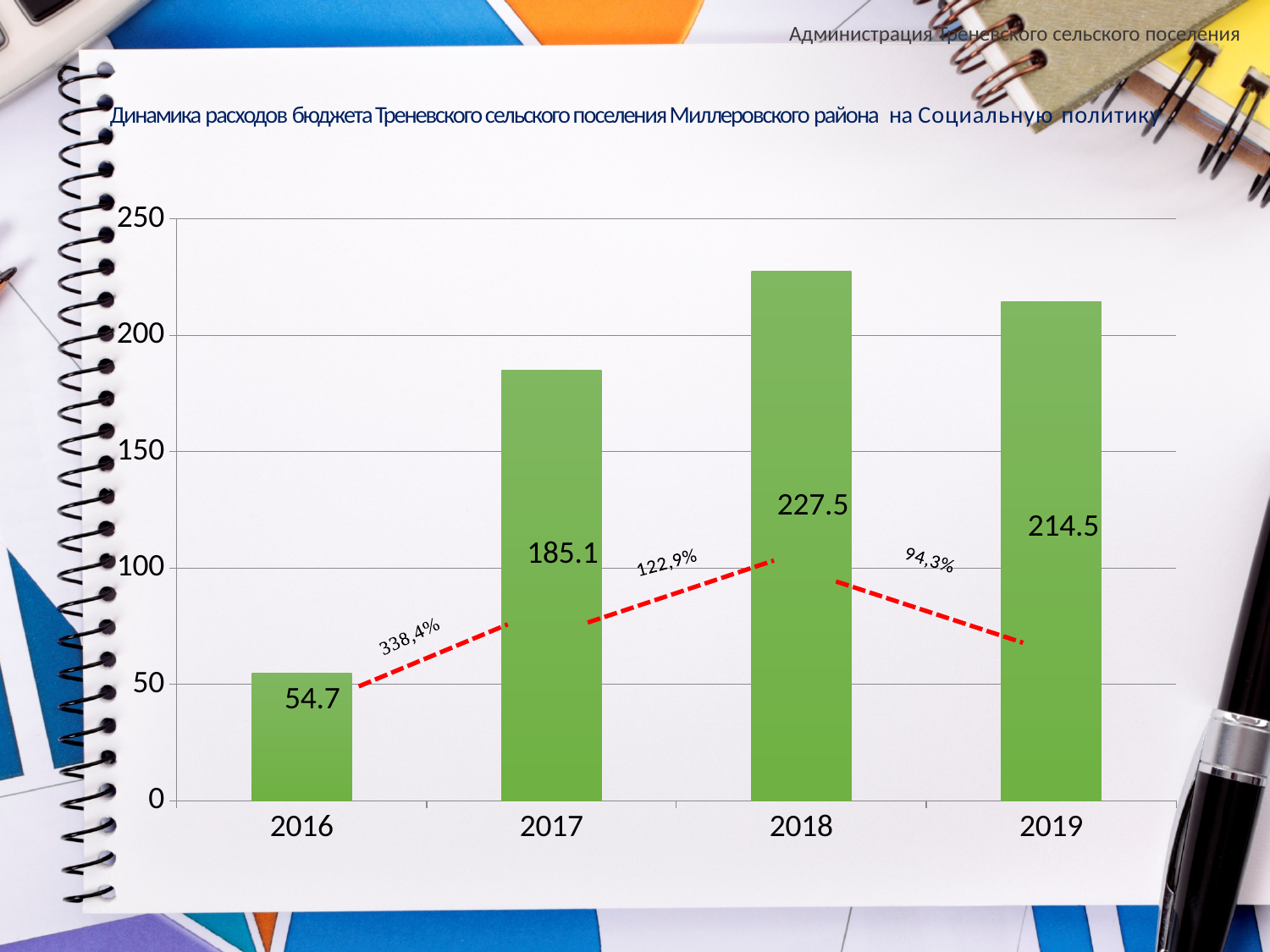
What kind of chart is this? bar chart How many years are shown on the x axis? 4 What is the value for 2019? 214.5 What percentage change is labelled on the dashed line between 2016 and 2017? 338,4% What is the value for 2018? 227.5 Which year has the lowest value? 2016 What is the difference between the values for 2018 and 2019? 13 Which is larger, the value for 2017 or the value for 2019? 2019 Is the value for 2017 greater or less than 200? less Which year has the highest value? 2018 What is the value for 2016? 54.7 What is the difference between the values for 2017 and 2016? 130.4